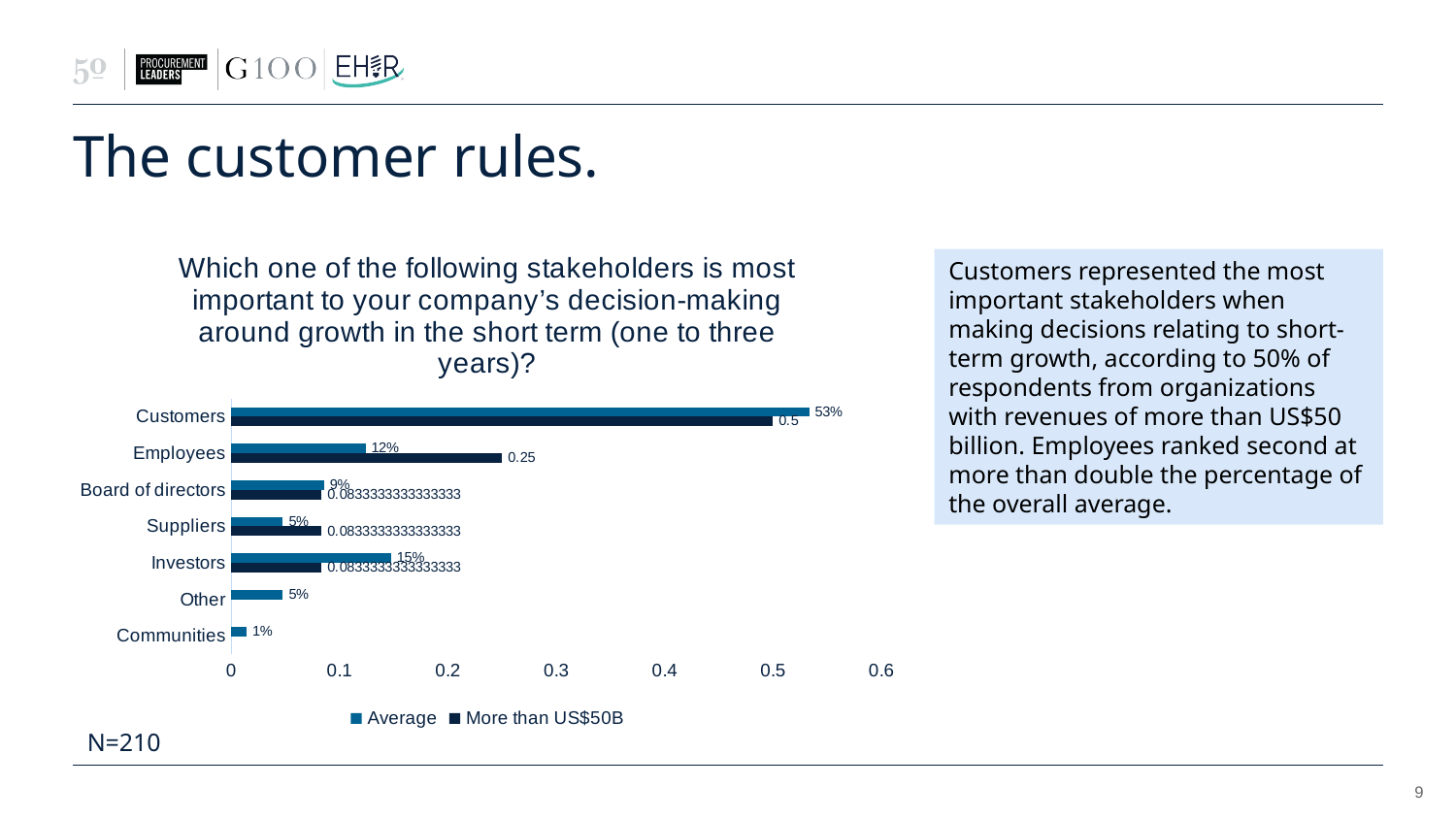
What is the More than US$50B value for Customers? 0.5 How many stakeholder categories are shown on the chart? 7 Is the More than US$50B value for Customers greater or less than 0.4? greater What is the Average value for Customers? 53% What is the difference between the Average values for Customers and Employees? 41% Which stakeholder has the highest Average value? Customers Which stakeholder has the lowest Average value? Communities What is the Average value for Investors? 15% How many series does the legend list? 2 What kind of chart is shown on the slide? Bar chart What is the More than US$50B value for Employees? 0.25 Which has the larger Average value, Investors or Employees? Investors